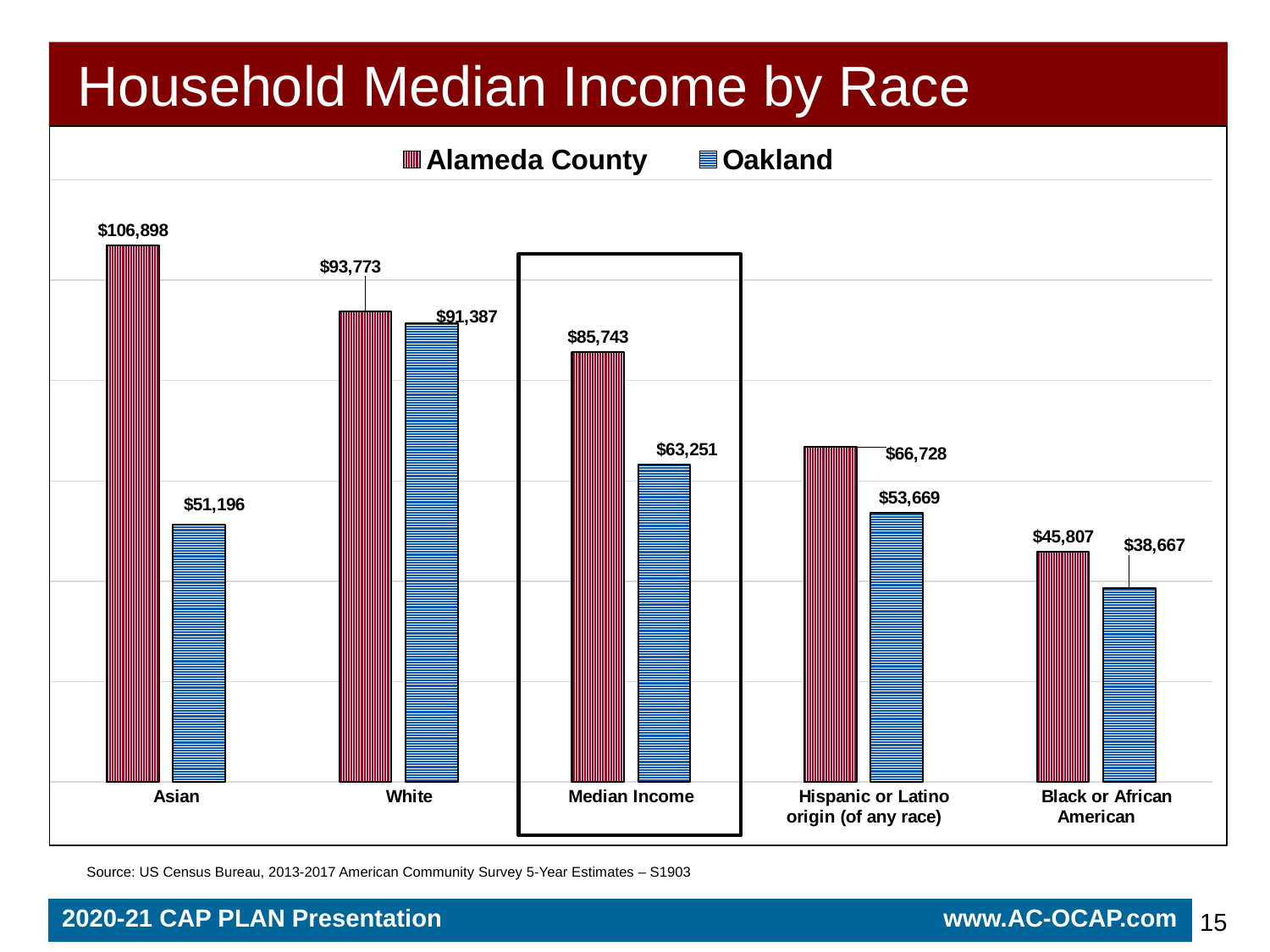
How many categories are shown on the x axis? 5 Which category has the highest Oakland value? White What is the Oakland household median income for White households? $91,387 What is the Alameda County household median income for Asian households? $106,898 Which is larger for the Median Income category: the Alameda County value or the Oakland value? Alameda County How many series does the legend list? 2 What is the Alameda County value for Black or African American households? $45,807 What is the Oakland value for Hispanic or Latino origin (of any race)? $53,669 Which category has the lowest Oakland value? Black or African American Which category has the highest Alameda County value? Asian What is the difference between the Alameda County and Oakland values for Black or African American households? $7,140 What is the difference between the Alameda County and Oakland values for Asian households? $55,702